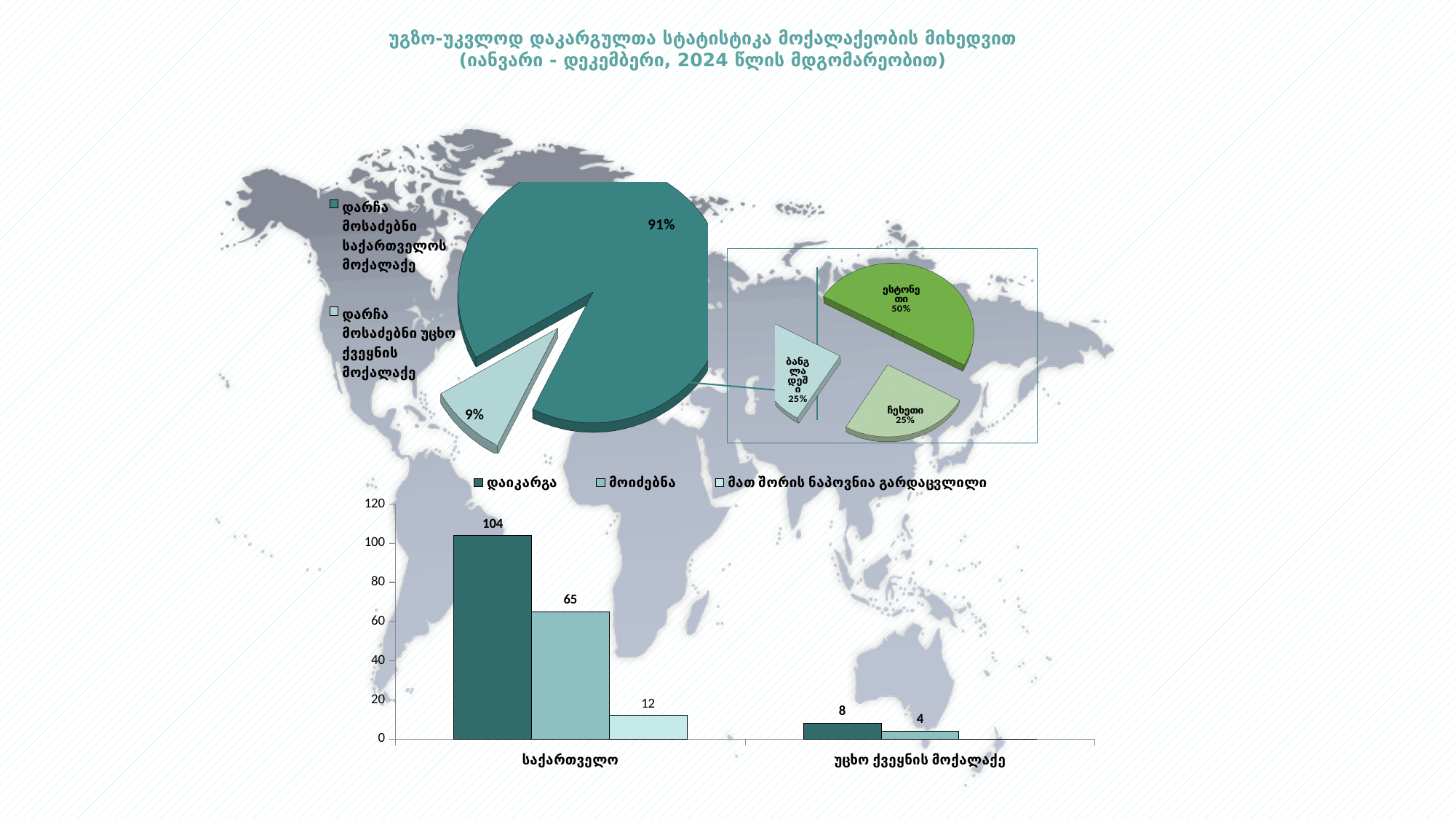
In the bar chart, how many series does the legend list? 3 In the bar chart, how many categories are shown on the x axis? 2 In the bar chart, what is the difference between დაიკარგა and მოიძებნა for საქართველო? 39 In the bar chart, what is the value of მათ შორის ნაპოვნია გარდაცვლილი for საქართველო? 12 In the bar chart, which category has the highest დაიკარგა value? საქართველო In the large pie chart, what share is labelled for დარჩა მოსაძებნი საქართველოს მოქალაქე? 91% In the small pie chart on the right, what share is labelled for ესტონეთი? 50% In the large pie chart, what share is labelled for დარჩა მოსაძებნი უცხო ქვეყნის მოქალაქე? 9% In the bar chart, what is the value of დაიკარგა for უცხო ქვეყნის მოქალაქე? 8 In the bar chart, what is the value of მოიძებნა for საქართველო? 65 In the bar chart, what is the value of დაიკარგა for საქართველო? 104 In the bar chart, what is the value of მოიძებნა for უცხო ქვეყნის მოქალაქე? 4